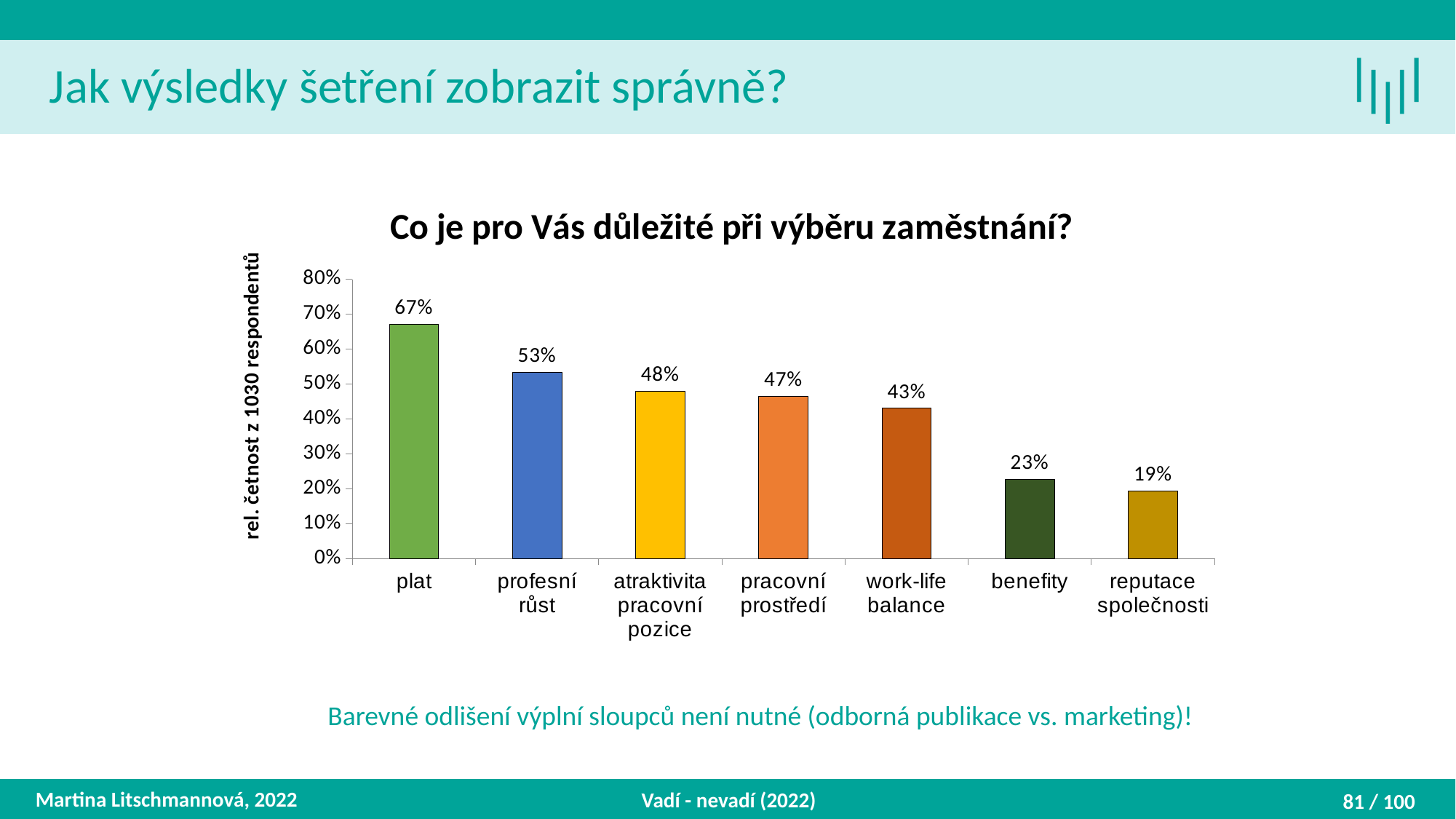
What is the difference between the values for plat and profesní růst? 14% What is the value for work-life balance? 43% Which category has the lowest value? reputace společnosti Is the value for benefity greater or less than 30%? less What kind of chart is shown on the slide? bar chart Which is larger, the value for profesní růst or the value for work-life balance? profesní růst What is the value for reputace společnosti? 19% What is the difference between the values for benefity and reputace společnosti? 4% How many categories are shown in the chart? 7 What is the title of the chart? Co je pro Vás důležité při výběru zaměstnání? Which category has the highest value? plat What is the value for plat? 67%